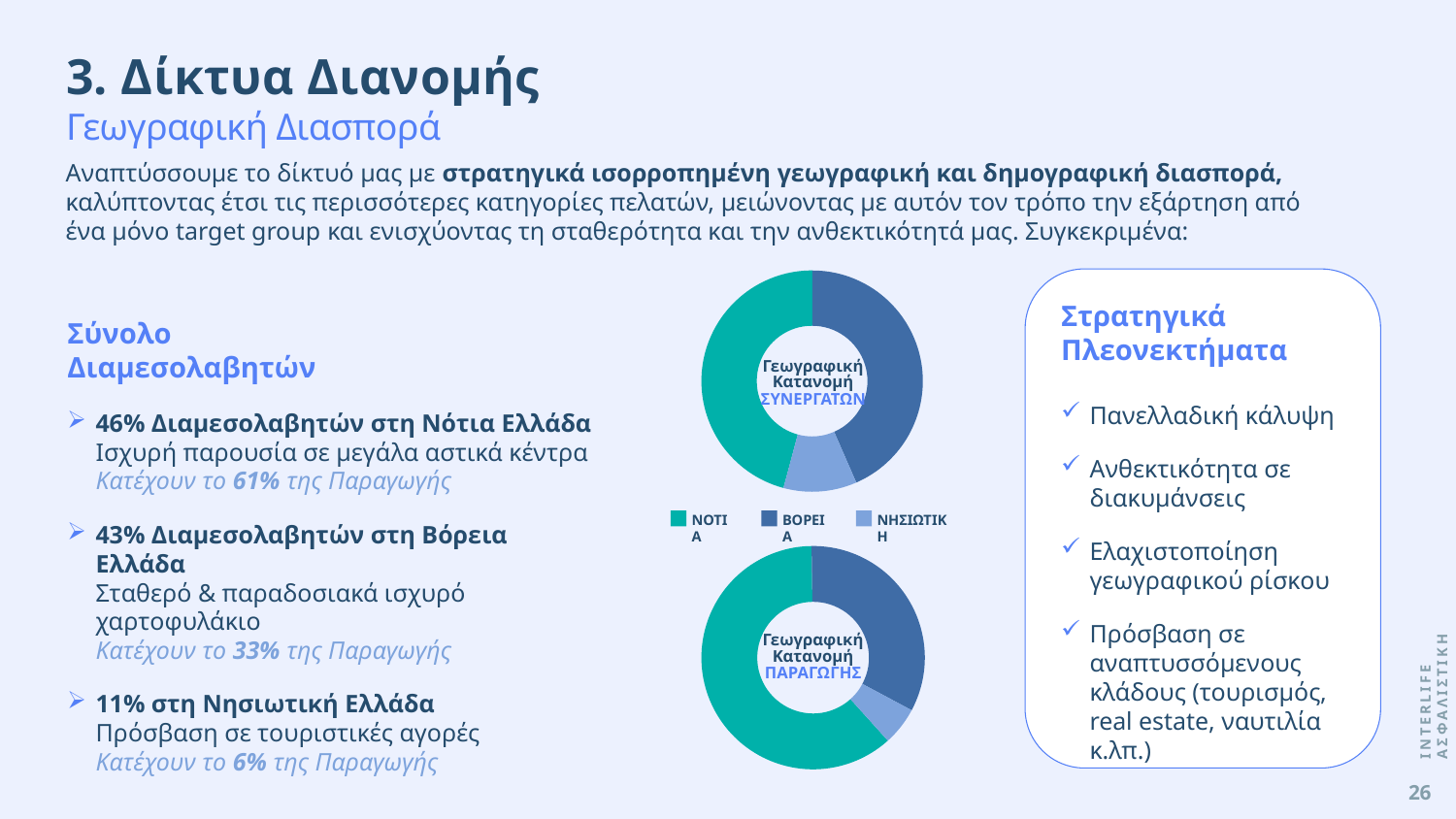
What are the three legend entries shown between the two charts? ΝΟΤΙΑ, ΒΟΡΕΙΑ, ΝΗΣΙΩΤΙΚΗ In the bottom chart, Γεωγραφική Κατανομή ΠΑΡΑΓΩΓΗΣ, which category has the largest slice? ΝΟΤΙΑ According to the slide, what share of production (Παραγωγή) comes from Νησιωτική Ελλάδα, as shown in the bottom chart? 6% What kind of chart is the top chart, Γεωγραφική Κατανομή ΣΥΝΕΡΓΑΤΩΝ? Doughnut chart What kind of chart is the bottom chart, Γεωγραφική Κατανομή ΠΑΡΑΓΩΓΗΣ? Doughnut chart How many categories does the legend of the top chart list? 3 According to the slide, what share of production (Παραγωγή) comes from Βόρεια Ελλάδα, as shown in the bottom chart? 33% What colour is used for the ΝΟΤΙΑ category in the charts? Teal/green In the top chart, Γεωγραφική Κατανομή ΣΥΝΕΡΓΑΤΩΝ, which category has the smallest slice? ΝΗΣΙΩΤΙΚΗ In the bottom chart, Γεωγραφική Κατανομή ΠΑΡΑΓΩΓΗΣ, which category has the smallest slice? ΝΗΣΙΩΤΙΚΗ According to the slide, what share of intermediaries (Διαμεσολαβητές) is in Νότια Ελλάδα, as shown in the top chart? 46% In the bottom chart, Γεωγραφική Κατανομή ΠΑΡΑΓΩΓΗΣ, is the slice for ΝΟΤΙΑ larger or smaller than the slice for ΒΟΡΕΙΑ? Larger